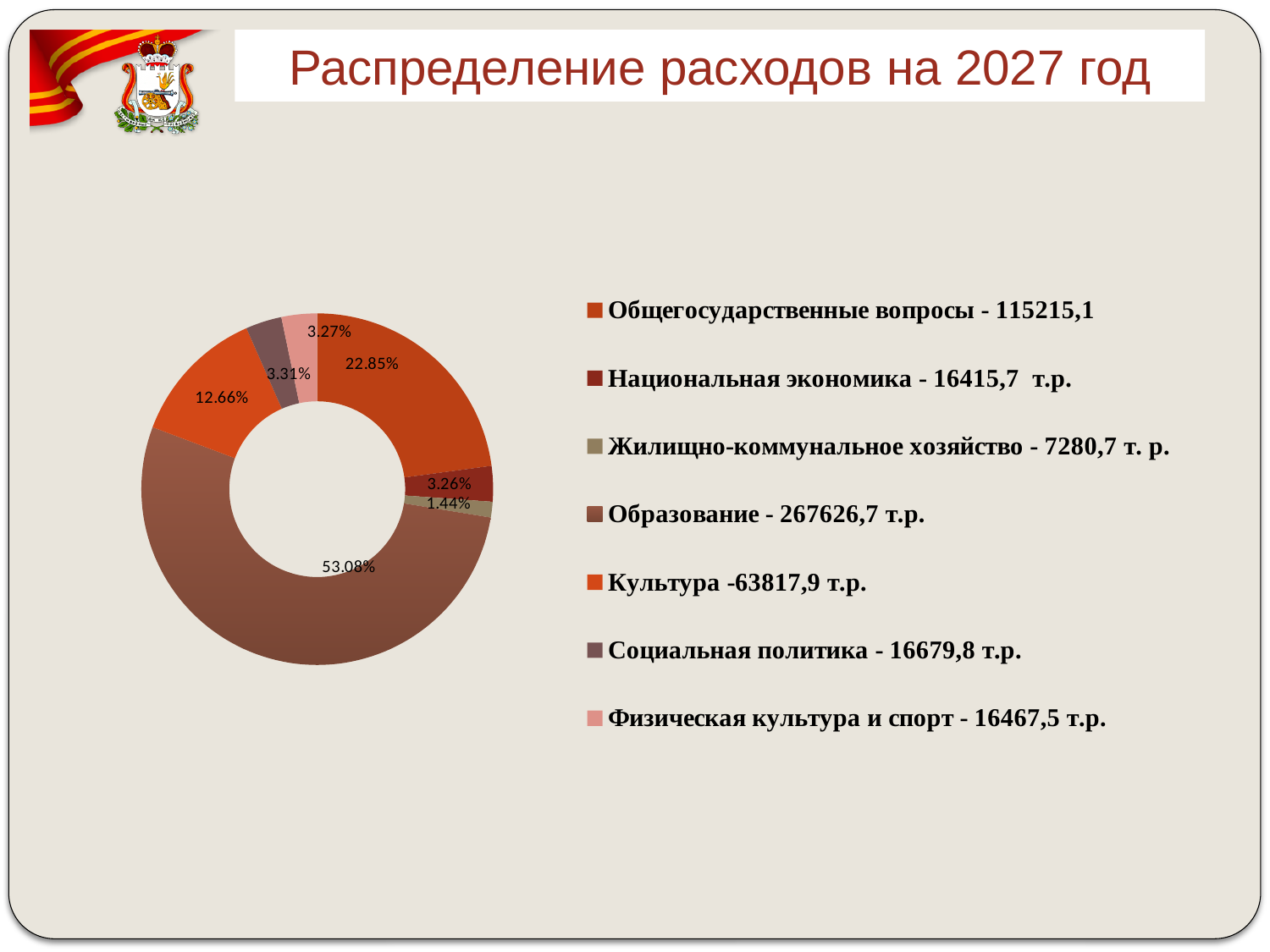
What percentage is shown for Культура? 12.66% What percentage is shown for Жилищно-коммунальное хозяйство? 1.44% What kind of chart is shown on the slide? Doughnut (pie) chart Which has a larger share, Культура or Социальная политика? Культура How many categories does the chart show? 7 What amount is listed in the legend for Образование? 267626,7 т.р. What is the difference in percentage points between Образование and Общегосударственные вопросы? 30.23 What is the title of the slide? Распределение расходов на 2027 год What percentage is shown for Общегосударственные вопросы? 22.85% Which category has the largest share of the chart? Образование What share of the chart does Образование account for? 53.08% Which category has the smallest share of the chart? Жилищно-коммунальное хозяйство